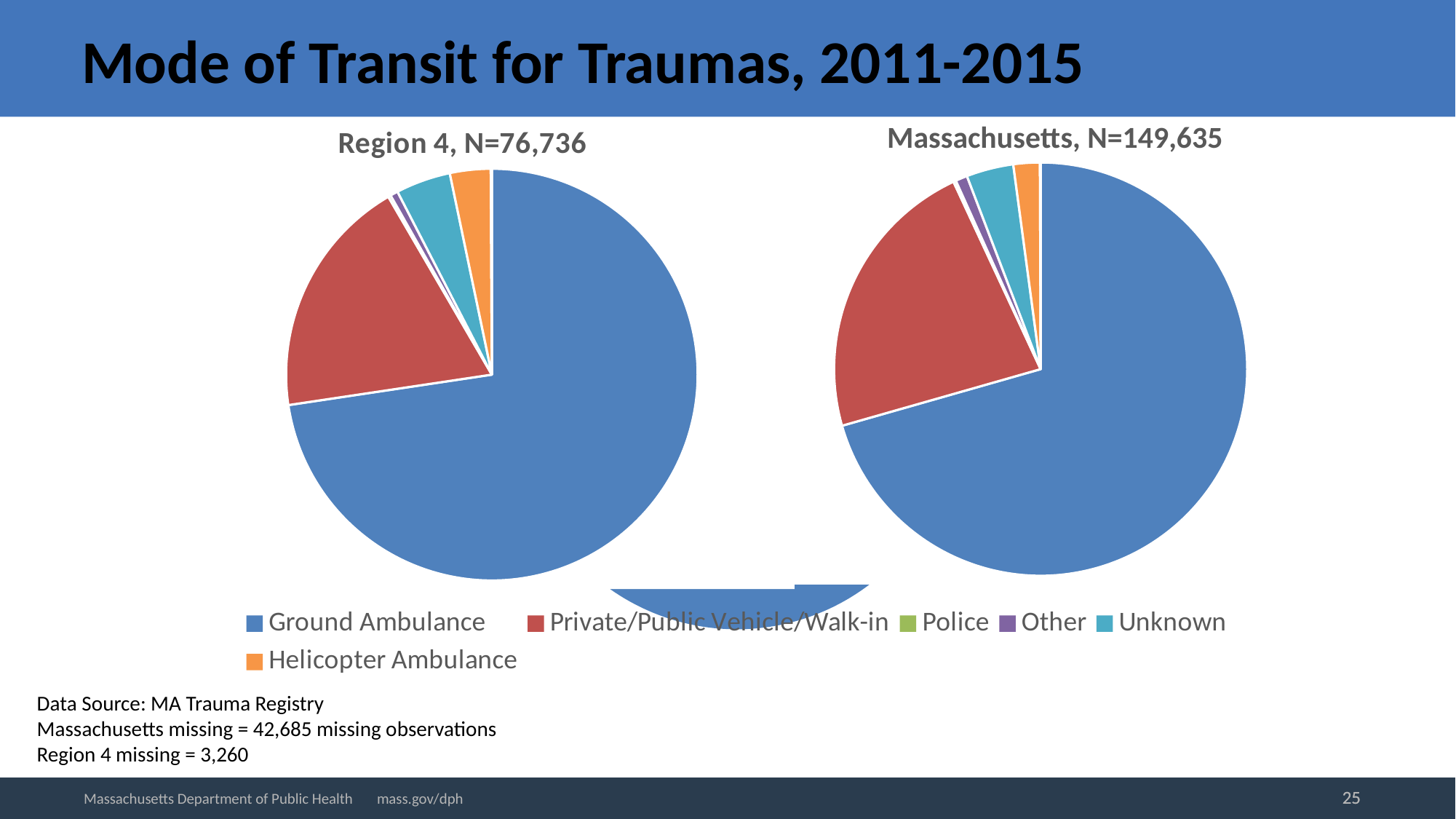
In the Region 4 pie chart, which mode of transit has the largest slice? Ground Ambulance In the Massachusetts pie chart, which mode of transit has the largest slice? Ground Ambulance In the Massachusetts pie chart, which is larger: Private/Public Vehicle/Walk-in or Unknown? Private/Public Vehicle/Walk-in How many pie charts are shown on the slide? 2 What is the N value shown in the title of the Massachusetts pie chart? 149,635 In the Region 4 pie chart, which is larger: Ground Ambulance or Private/Public Vehicle/Walk-in? Ground Ambulance In the Region 4 pie chart, which is larger: Ground Ambulance or Helicopter Ambulance? Ground Ambulance What is the N value shown in the title of the Region 4 pie chart? 76,736 How many categories does the legend list? 6 What kind of chart is used on this slide to show mode of transit? Pie chart